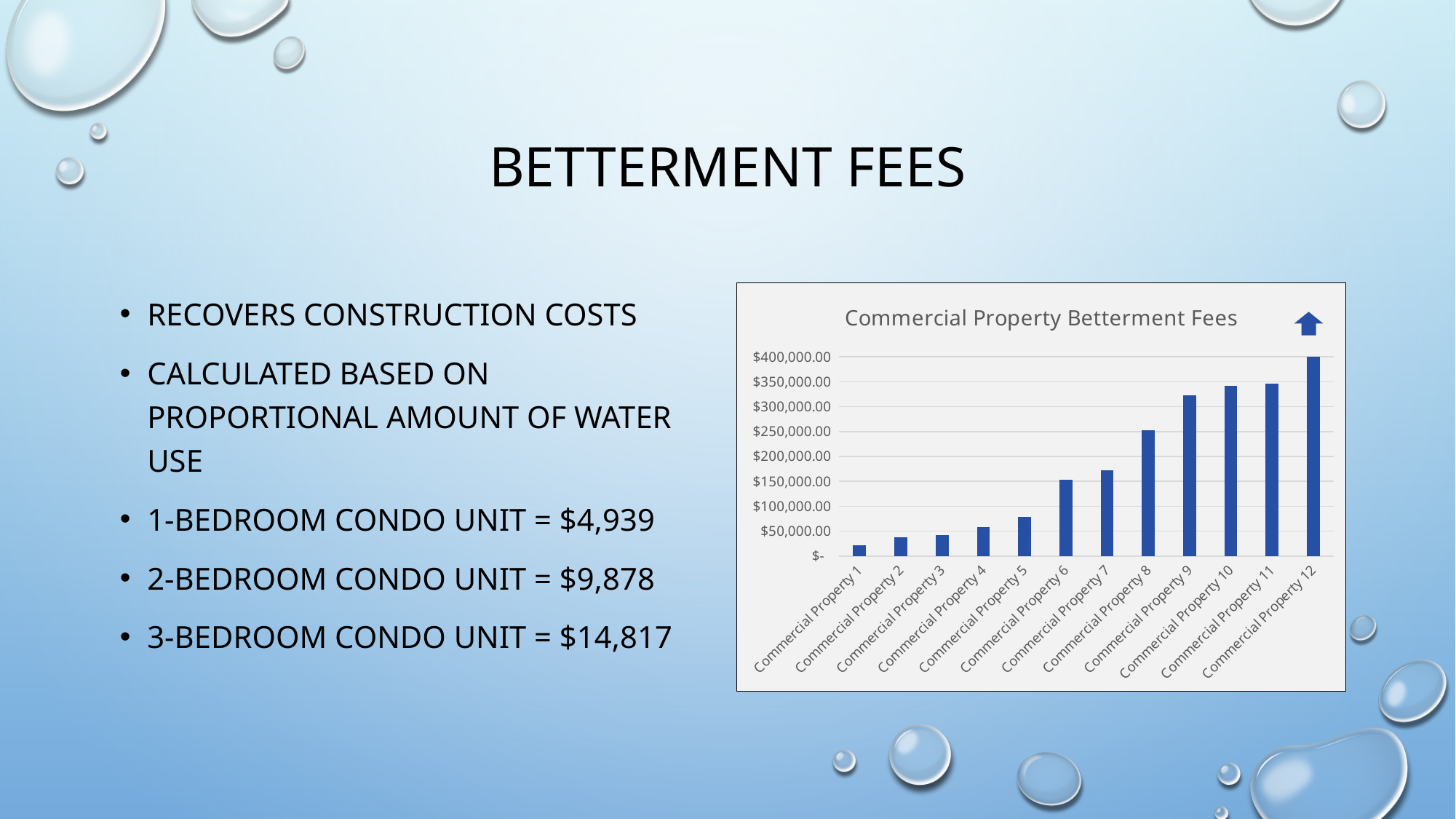
Do the betterment fees rise or fall from Commercial Property 1 to Commercial Property 12? rise Is the betterment fee for Commercial Property 5 greater or less than $100,000.00? less Which has a lower betterment fee, Commercial Property 4 or Commercial Property 7? Commercial Property 4 Is the betterment fee for Commercial Property 8 greater or less than $200,000.00? greater What is the title of the chart? Commercial Property Betterment Fees Which has a higher betterment fee, Commercial Property 6 or Commercial Property 9? Commercial Property 9 Is the betterment fee for Commercial Property 1 greater or less than $50,000.00? less Which commercial property has the lowest betterment fee? Commercial Property 1 What type of chart is shown on the slide? bar chart Which commercial property has the highest betterment fee? Commercial Property 12 How many commercial properties are plotted in the chart? 12